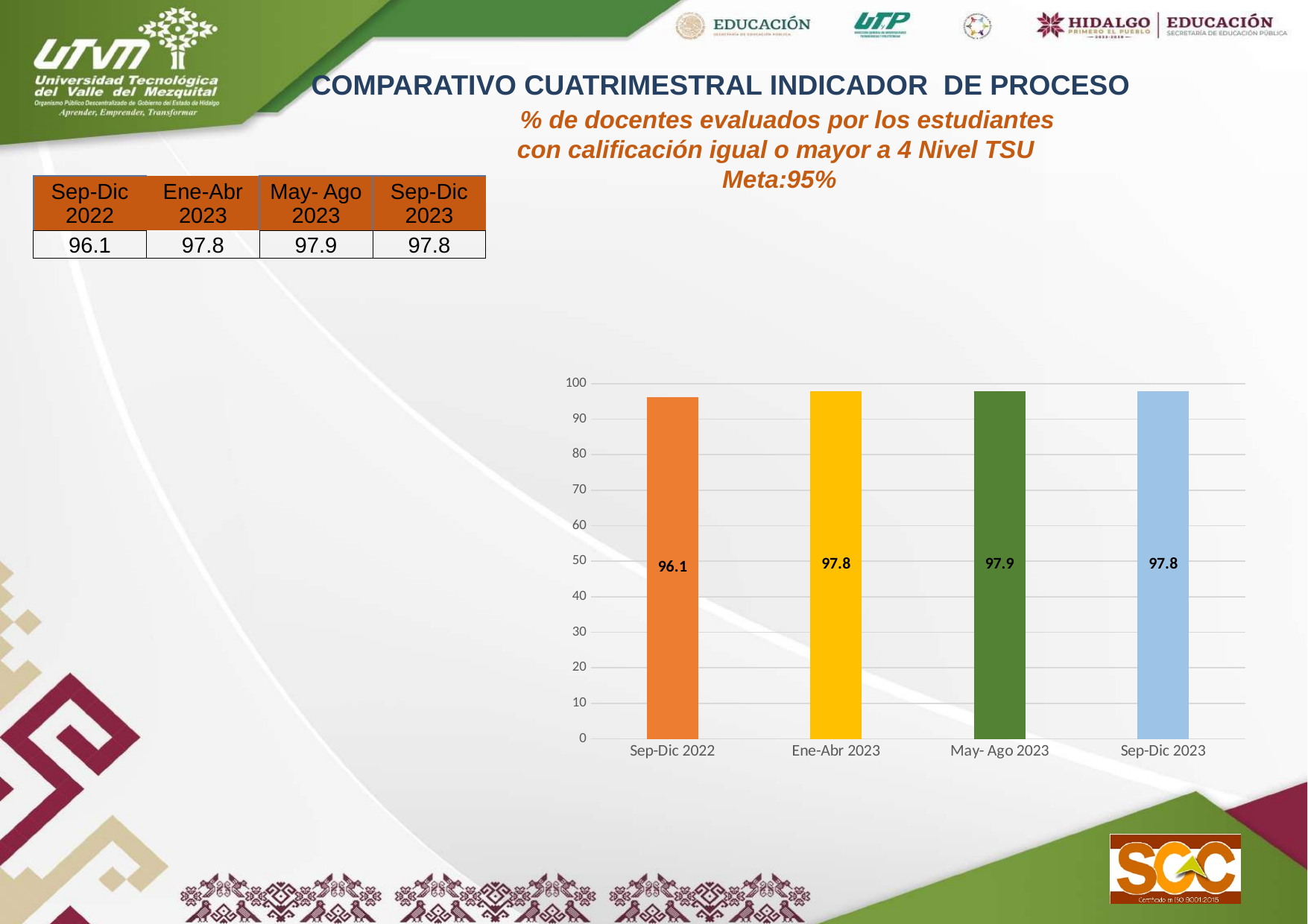
What is the target (Meta) stated in the chart subtitle? 95% How many periods are shown on the x axis of the chart? 4 What colour is the bar for May- Ago 2023? green What is the difference between the values for May- Ago 2023 and Sep-Dic 2022? 1.8 Which is larger, the value for Sep-Dic 2022 or the value for Sep-Dic 2023? Sep-Dic 2023 What is the difference between the values for Ene-Abr 2023 and Sep-Dic 2022? 1.7 What is the value for Ene-Abr 2023? 97.8 What is the value for May- Ago 2023? 97.9 What kind of chart is shown on the slide? bar chart Which period has the lowest value? Sep-Dic 2022 Is the value for Sep-Dic 2022 greater or less than 90? greater What is the value for Sep-Dic 2022? 96.1